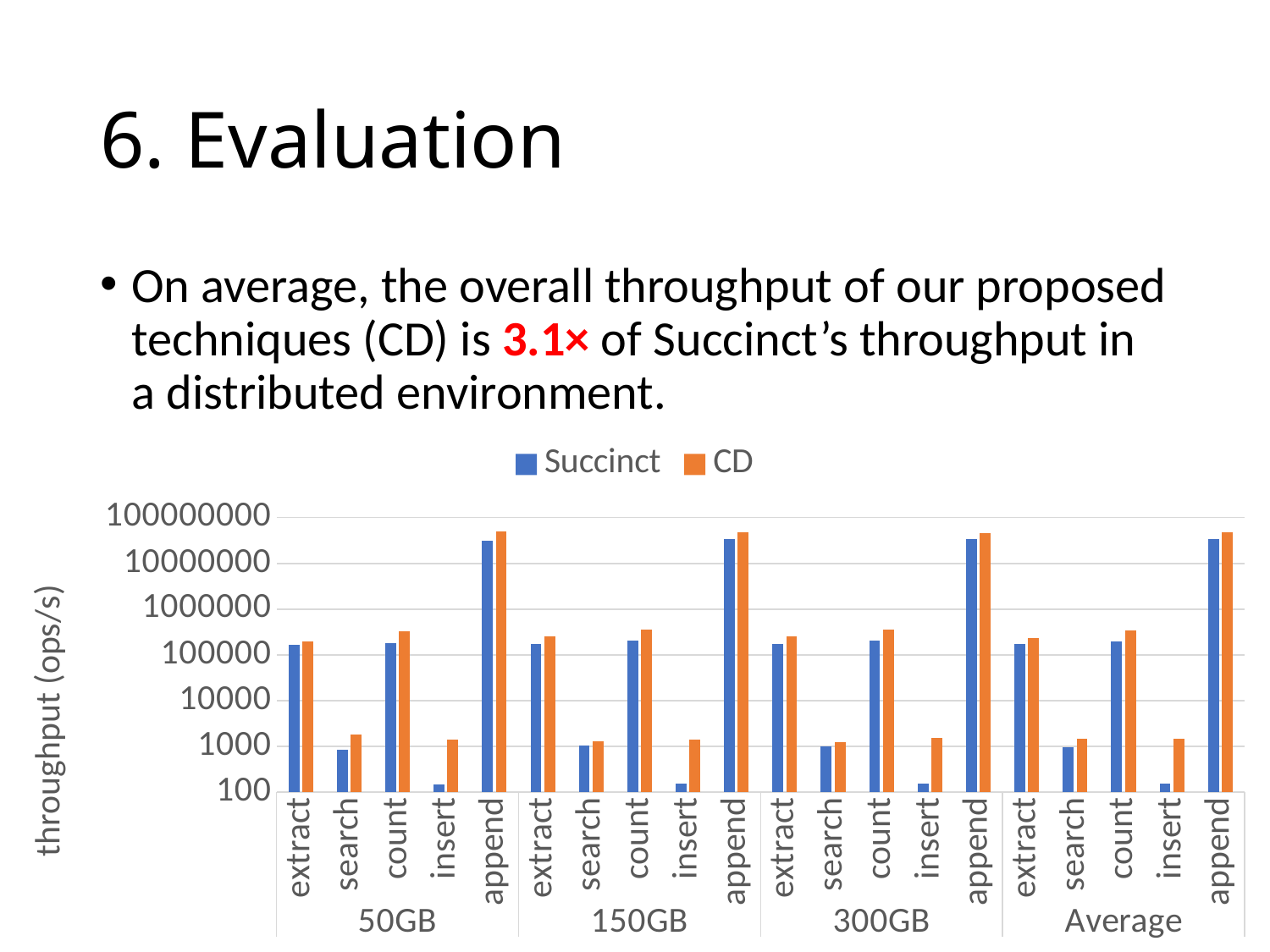
How many data-size groups are shown along the x axis? 4 Which operation has the lowest Succinct throughput in the 300GB group? insert How many operation categories are plotted within each data-size group? 5 Which operation has the highest throughput for both series in the 50GB group? append What is the label of the y axis? throughput (ops/s) How many series does the legend list? 2 Is the CD throughput for append in the Average group greater or less than 10000000? greater For append in the 150GB group, which series has the larger throughput, Succinct or CD? CD Which two series are listed in the legend? Succinct and CD Is the Succinct throughput for insert in the 50GB group greater or less than 1000? less Is the CD throughput for count in the 300GB group greater or less than 100000? greater What kind of chart is shown on the slide? bar chart